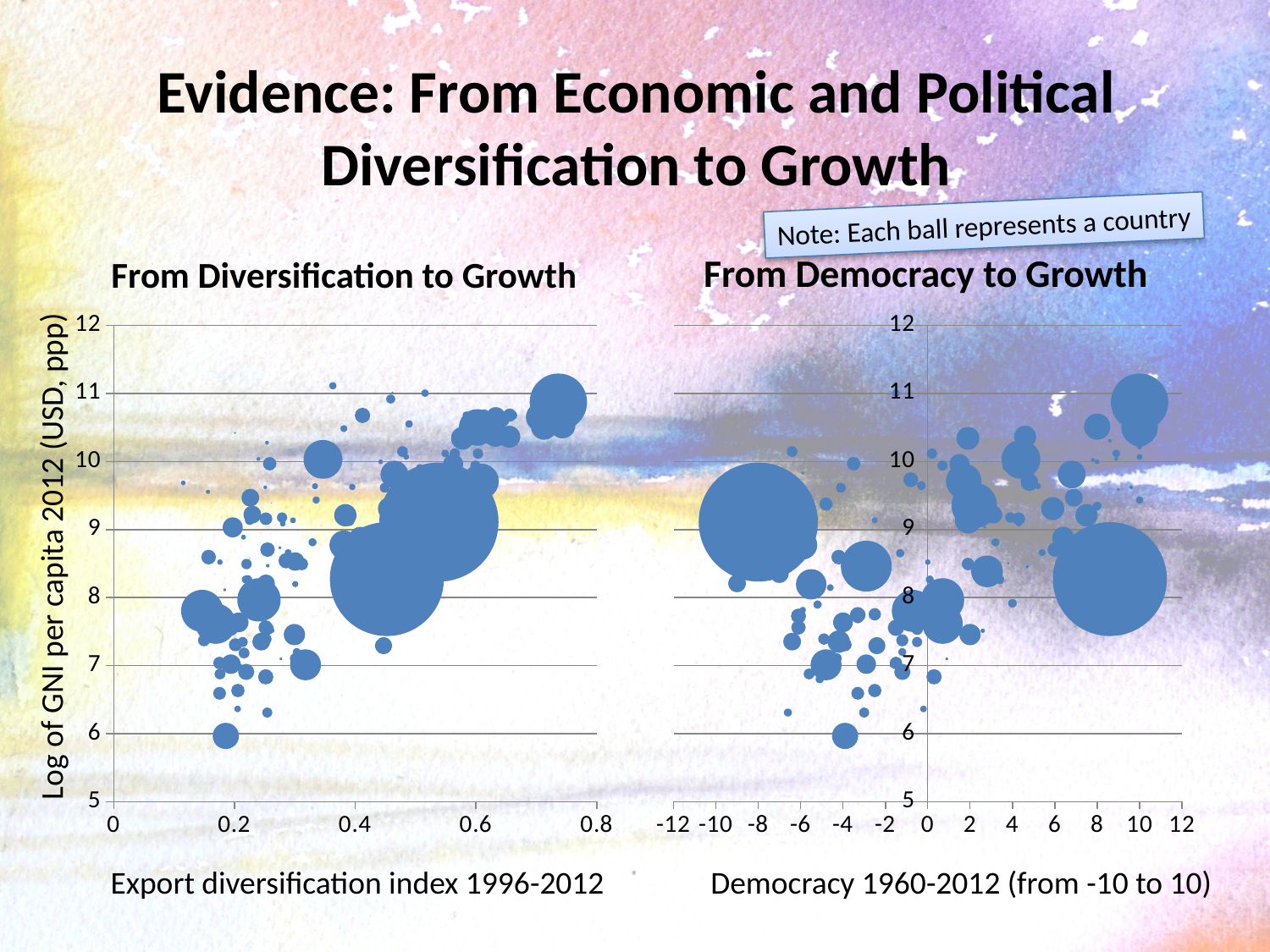
In the right chart 'From Democracy to Growth', is the value of the lowest bubble greater or less than 7? less What kind of chart is the chart on the right, titled 'From Democracy to Growth'? bubble chart In the left chart 'From Diversification to Growth', do the values on the y axis generally rise or fall as the export diversification index increases? rise What is the title of the chart on the left? From Diversification to Growth According to the note on the slide, what does each ball in the charts represent? a country In the left chart 'From Diversification to Growth', is the value of the bubble furthest to the right greater or less than 10? greater What kind of chart is the chart on the left, titled 'From Diversification to Growth'? bubble chart In the left chart 'From Diversification to Growth', is the value of the largest bubble greater or less than 7? greater